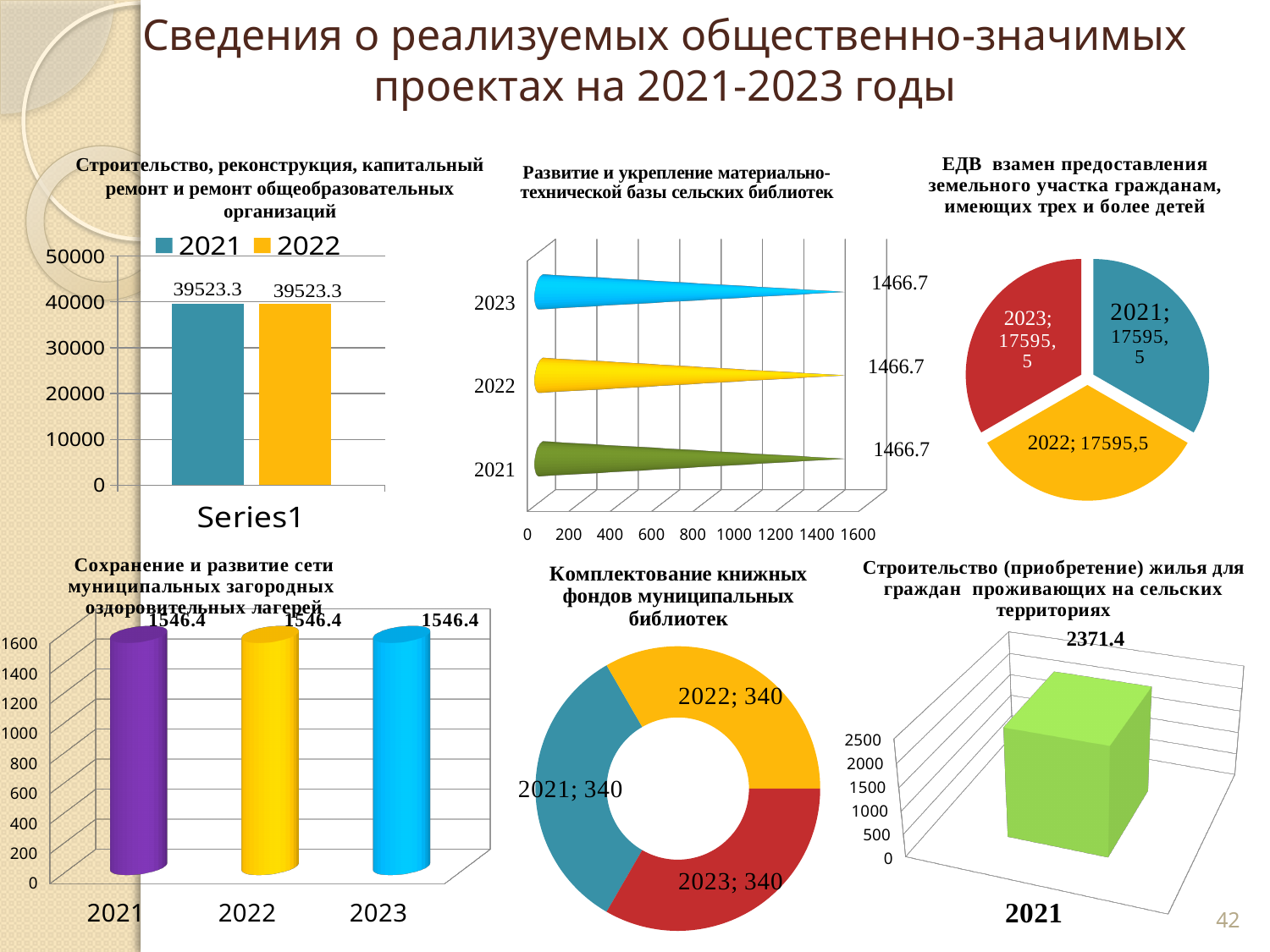
In the chart titled "Строительство, реконструкция, капитальный ремонт и ремонт общеобразовательных организаций", what is the value for 2021? 39523.3 In the chart titled "Сохранение и развитие сети муниципальных загородных оздоровительных лагерей", what is the value for 2023? 1546.4 In the doughnut chart titled "Комплектование книжных фондов муниципальных библиотек", what is the value for 2021? 340 In the chart titled "Развитие и укрепление материально-технической базы сельских библиотек", what kind of chart is it? bar chart In the chart titled "Сохранение и развитие сети муниципальных загородных оздоровительных лагерей", is the value for 2021 greater or less than 1400? greater In the chart titled "Строительство (приобретение) жилья для граждан проживающих на сельских территориях", what is the value for 2021? 2371.4 In the pie chart titled "ЕДВ взамен предоставления земельного участка гражданам, имеющих трех и более детей", how many slices are there? 3 In the pie chart titled "ЕДВ взамен предоставления земельного участка гражданам, имеющих трех и более детей", what is the value for 2023? 17595,5 In the chart titled "Развитие и укрепление материально-технической базы сельских библиотек", how many categories are shown? 3 In the chart titled "Строительство, реконструкция, капитальный ремонт и ремонт общеобразовательных организаций", how many series does the legend list? 2 In the chart titled "Развитие и укрепление материально-технической базы сельских библиотек", what is the value for 2022? 1466.7 In the doughnut chart titled "Комплектование книжных фондов муниципальных библиотек", what is the total of all three values? 1020